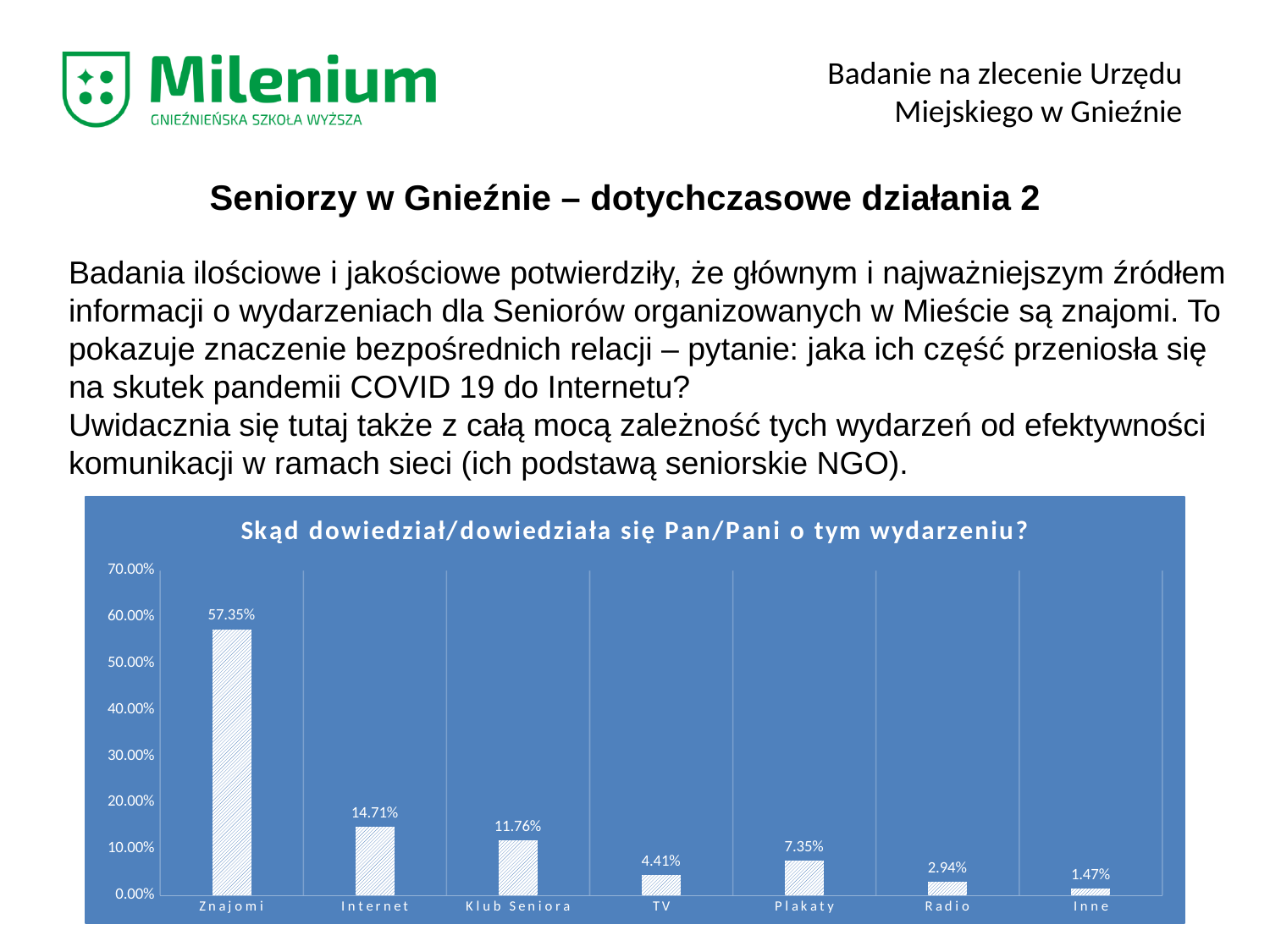
Which is larger, the value for Plakaty or the value for TV? Plakaty What is the difference between the values for Plakaty and TV? 2.94% What is the value for Klub Seniora? 11.76% What is the value for Znajomi? 57.35% What is the value for Internet? 14.71% Which category has the lowest value? Inne Which category has the highest value? Znajomi What is the difference between the values for Znajomi and Internet? 42.64% What kind of chart is shown on the slide? bar chart How many categories are shown on the x axis? 7 Is the value for Klub Seniora greater or less than 10.00%? greater What is the value for Radio? 2.94%